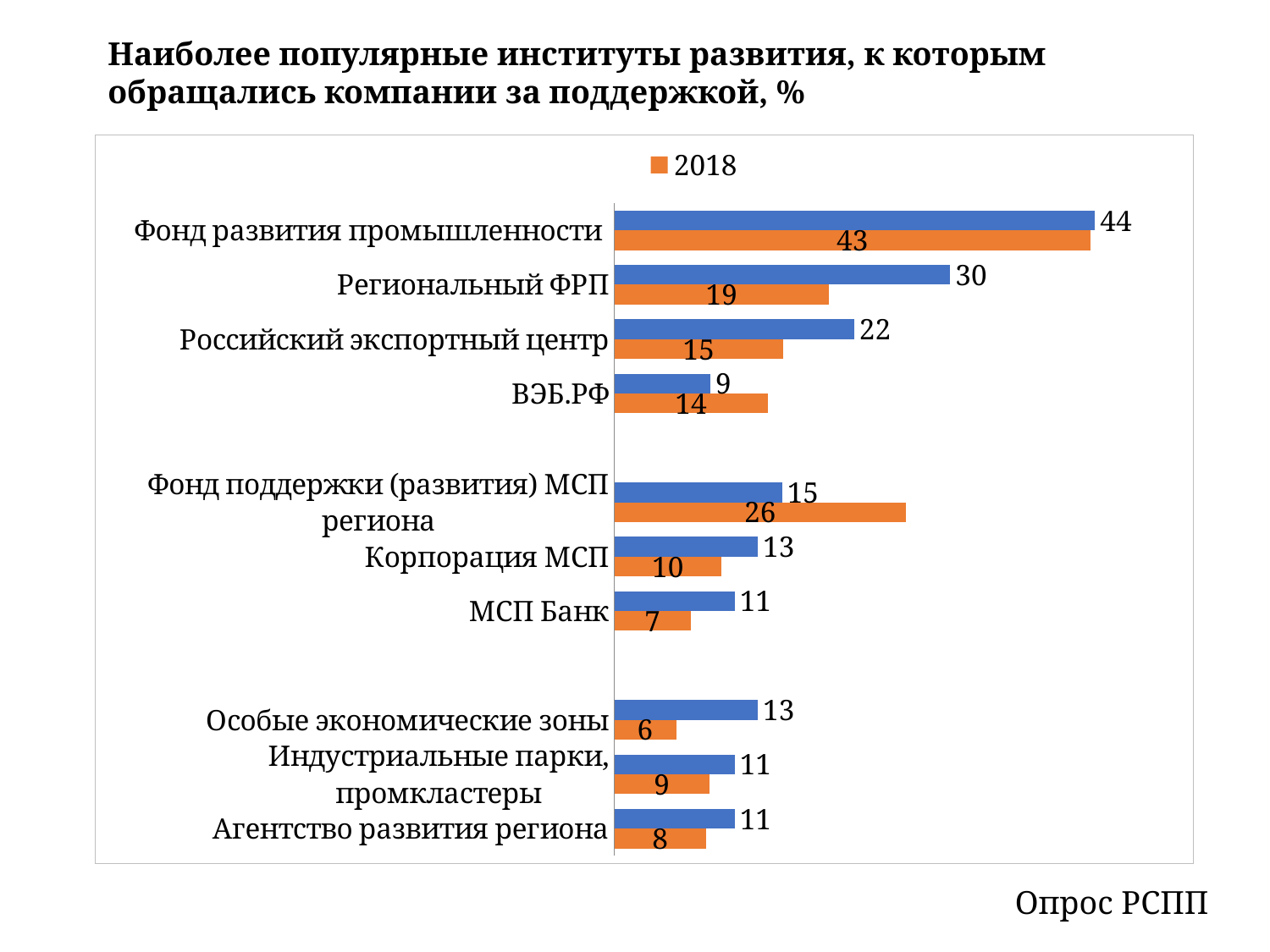
For ВЭБ.РФ, which is larger: the blue series value or the 2018 value? 2018 How many categories are shown on the chart? 10 What is the value of the blue series for Региональный ФРП? 30 What is the difference between the blue series value and the 2018 value for Региональный ФРП? 11 What is the 2018 value for Фонд поддержки (развития) МСП региона? 26 What kind of chart is shown on the slide? bar chart What is the 2018 value for Фонд развития промышленности? 43 How many series does the legend list? 1 Which category has the lowest value in the 2018 series? Особые экономические зоны What is the title of the chart? Наиболее популярные институты развития, к которым обращались компании за поддержкой, % What is the 2018 value for ВЭБ.РФ? 14 Which category has the highest value in the 2018 series? Фонд развития промышленности